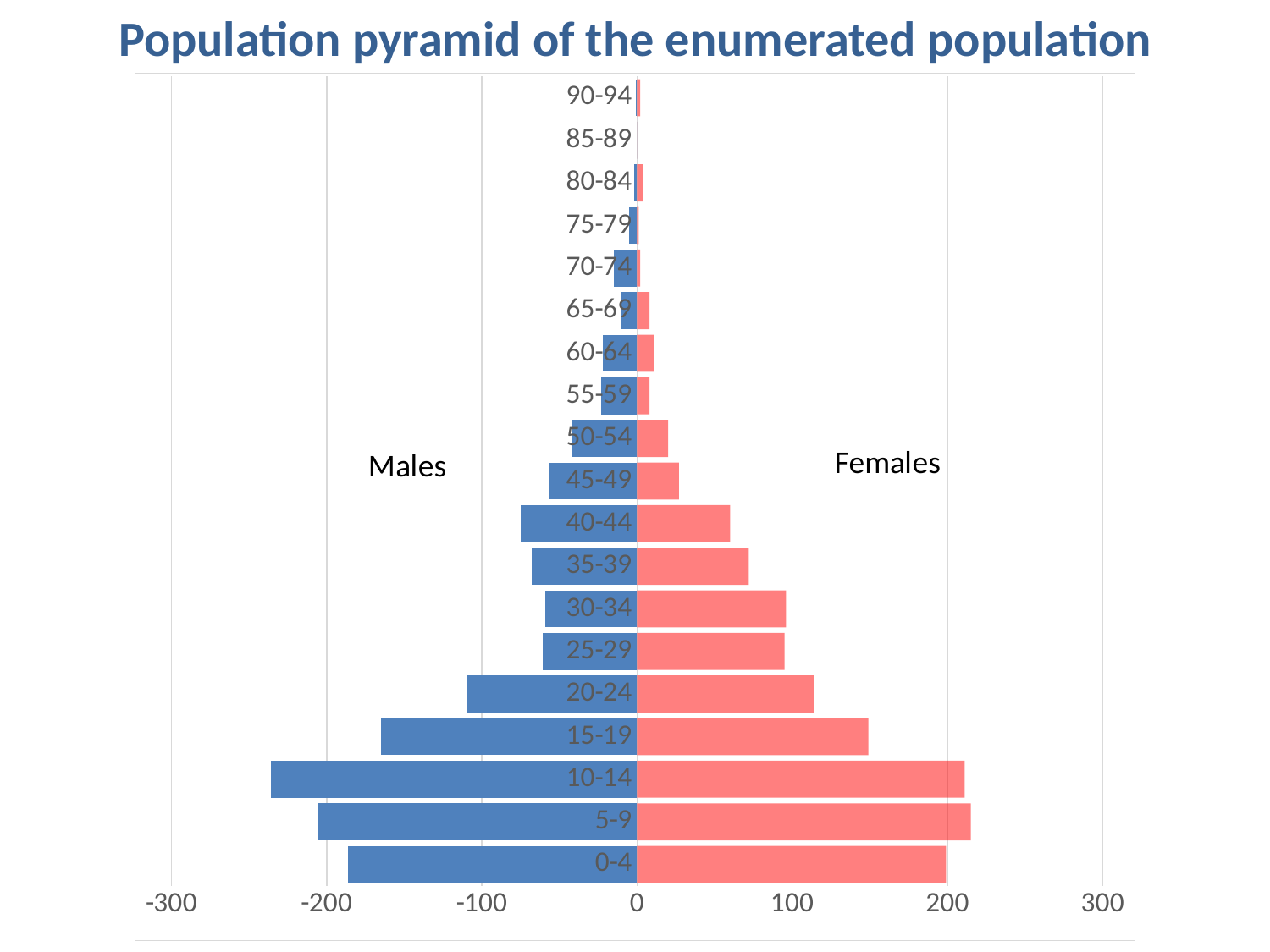
Which Males bar is longer, 10-14 or 5-9? 10-14 Is the Females value for the 40-44 age group greater or less than 100? less How many age groups are shown on the chart? 19 Is the Females value for the 5-9 age group greater or less than 200? greater Which is longer, the Males bar or the Females bar for the 45-49 age group? Males What is the title of the chart? Population pyramid of the enumerated population What kind of chart is shown on the slide? Bar chart Which colour represents Males on the chart? Blue Is the Males bar for the 10-14 age group longer or shorter than 200 in magnitude? longer Which age group has the longest Males bar? 10-14 Which is longer, the Males bar or the Females bar for the 15-19 age group? Males